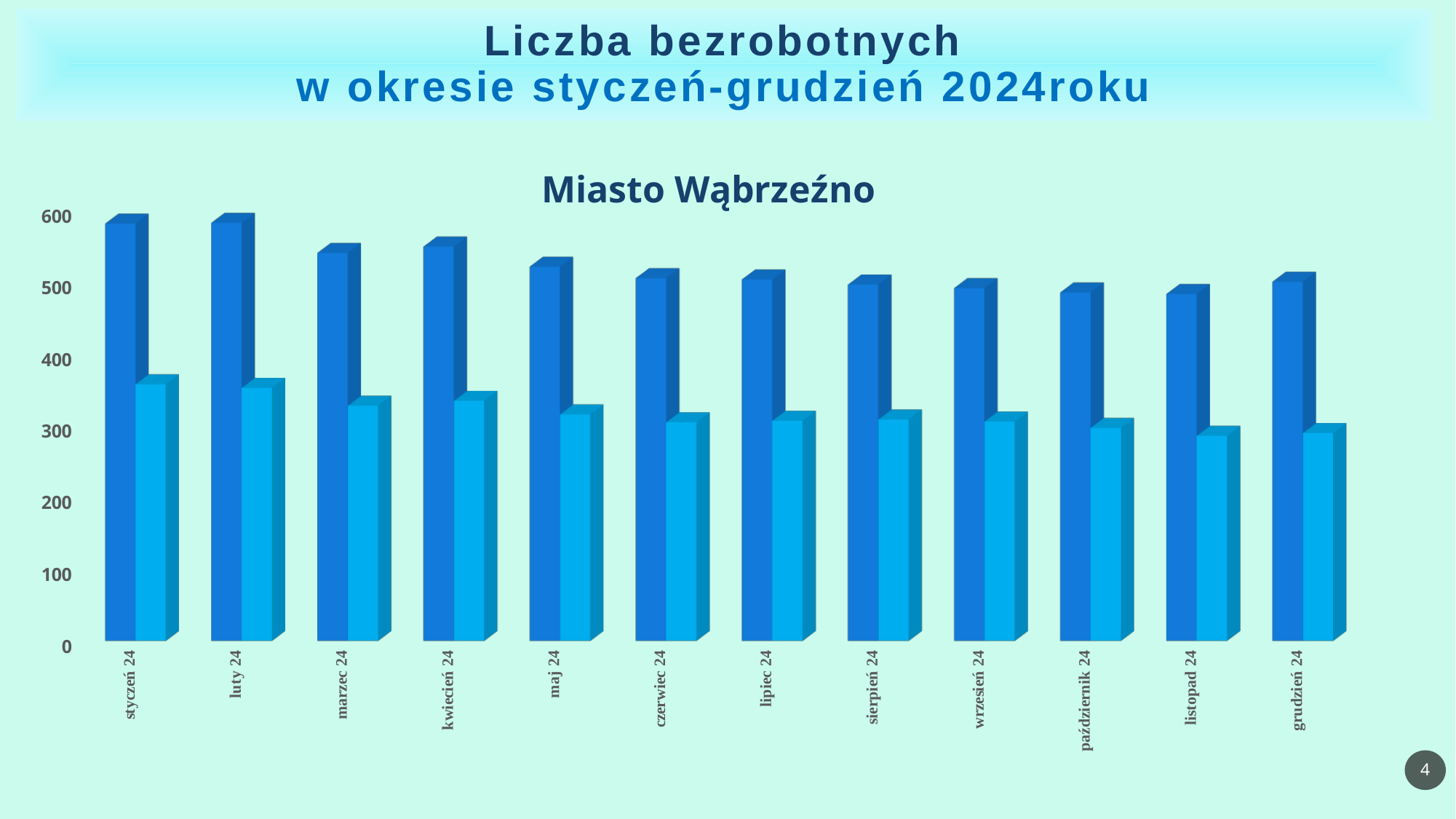
Do the dark blue bars generally rise or fall from styczeń 24 to grudzień 24? fall Is the value of the light blue bar for maj 24 greater or less than 400? less What is the highest value shown on the vertical axis of the chart? 600 How many bars are plotted for each month in the chart? 2 Is the value of the dark blue bar for styczeń 24 greater or less than 500? greater What kind of chart is shown on the slide? bar chart Which month has the larger dark blue bar, styczeń 24 or grudzień 24? styczeń 24 Is the value of the dark blue bar for marzec 24 greater or less than 500? greater How many months are shown on the x axis of the chart? 12 What is the title printed above the chart? Miasto Wąbrzeźno Which month has the larger light blue bar, styczeń 24 or listopad 24? styczeń 24